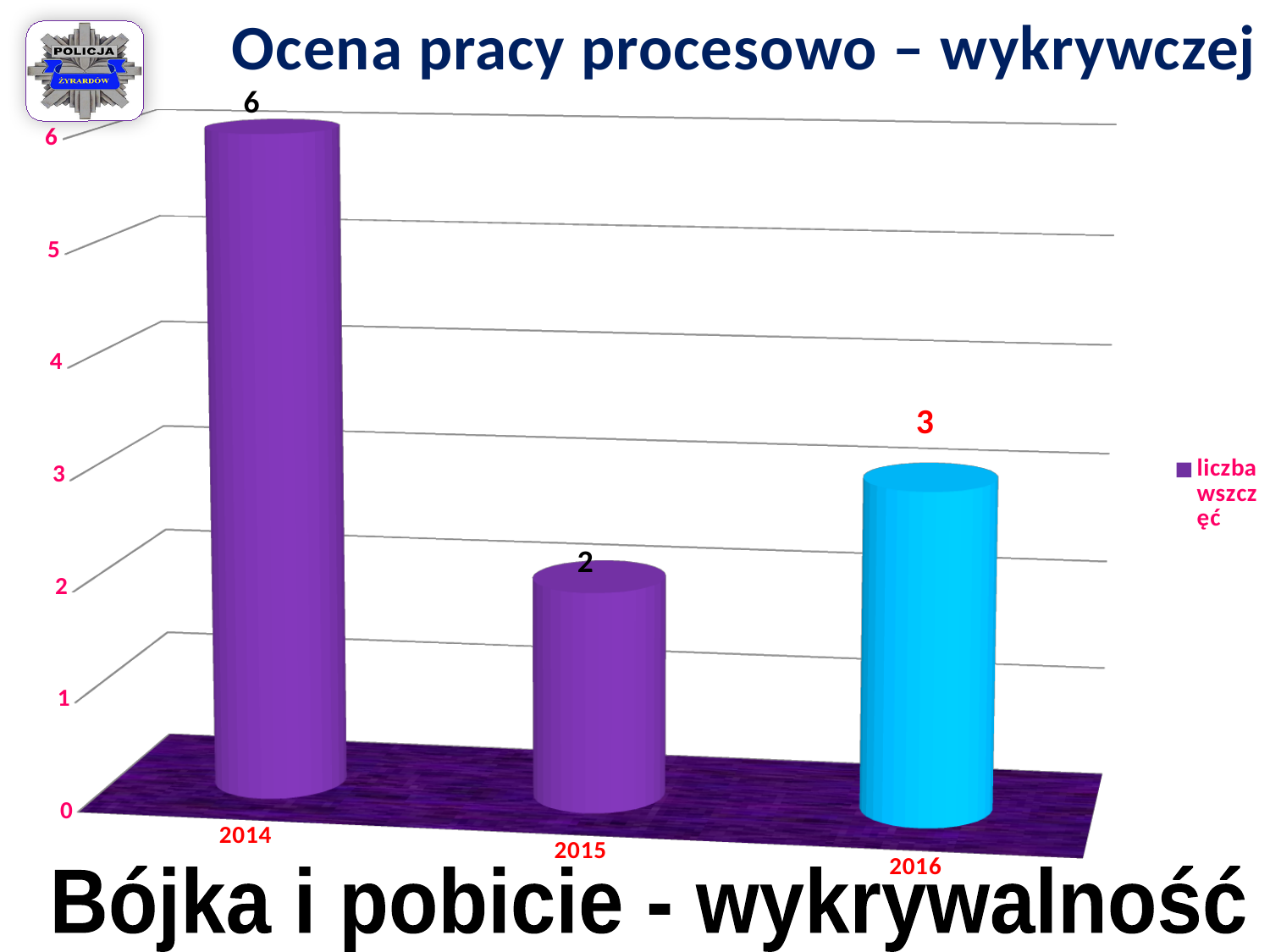
What is the legend entry for the series? liczba wszczęć What is the value for 2015? 2 What is the value for 2016? 3 What kind of chart is shown on the slide? bar chart How many series does the legend list? 1 Which is larger, the value for 2015 or the value for 2016? 2016 What is the value for 2014? 6 Which year has the lowest value? 2015 What is the difference between the values for 2014 and 2015? 4 How many years are shown on the x axis? 3 What is the difference between the values for 2016 and 2015? 1 Which year has the highest value? 2014